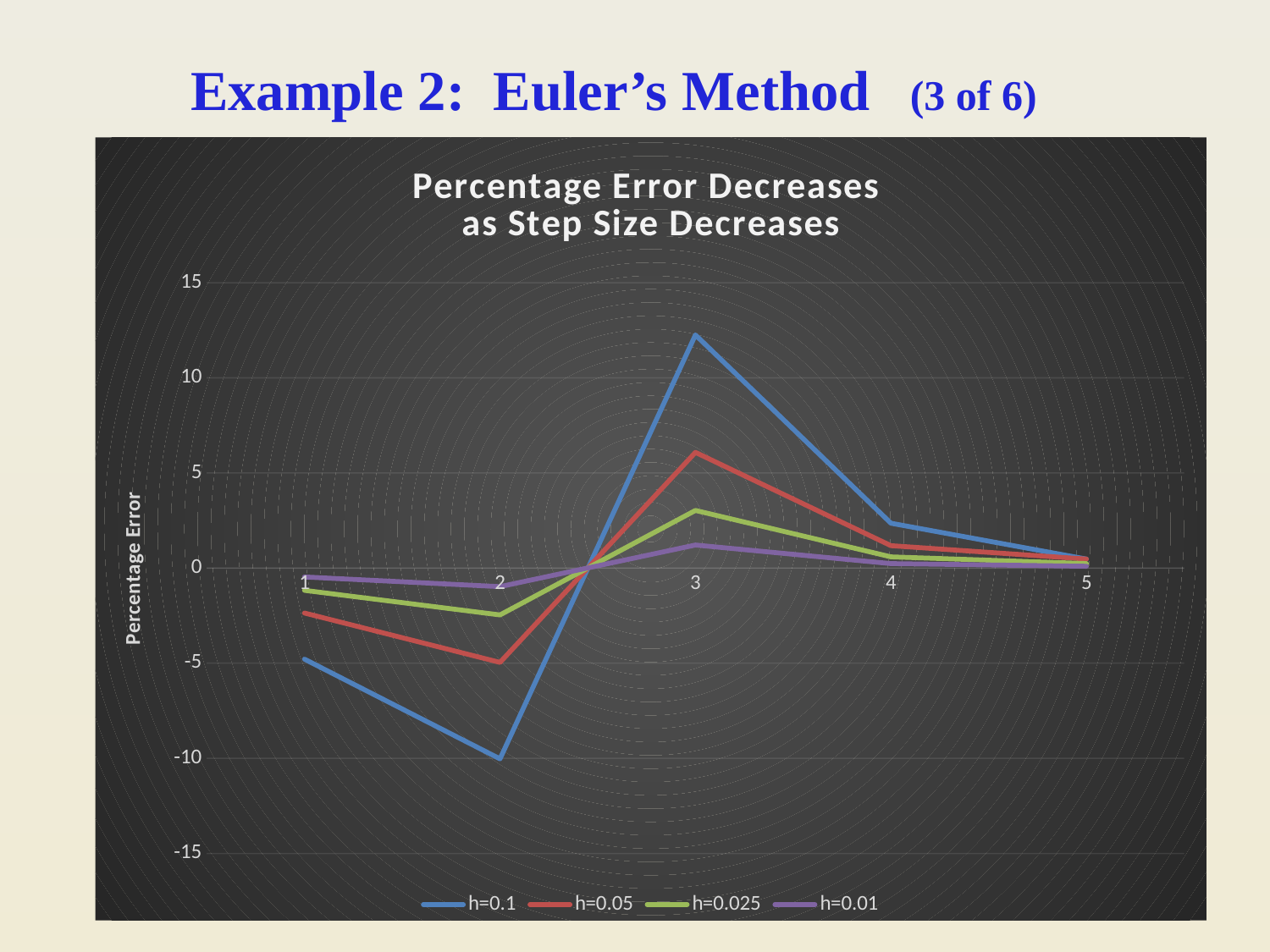
Which series has the lowest value at x = 2? h=0.1 For the h=0.1 series, at which x value is the percentage error lowest? 2 Which series has the highest value at x = 3? h=0.1 Does the h=0.1 series rise or fall from x = 3 to x = 5? fall At x = 3, which is larger: the value for h=0.1 or the value for h=0.01? h=0.1 What is the label on the vertical axis of the chart? Percentage Error What kind of chart is shown on the slide? line chart Is the value for h=0.1 at x = 3 greater or less than 10? greater For the h=0.1 series, at which x value is the percentage error highest? 3 How many points are plotted along the x axis for each series? 5 How many series does the legend list? 4 Is the value for h=0.1 at x = 2 greater or less than -5? less